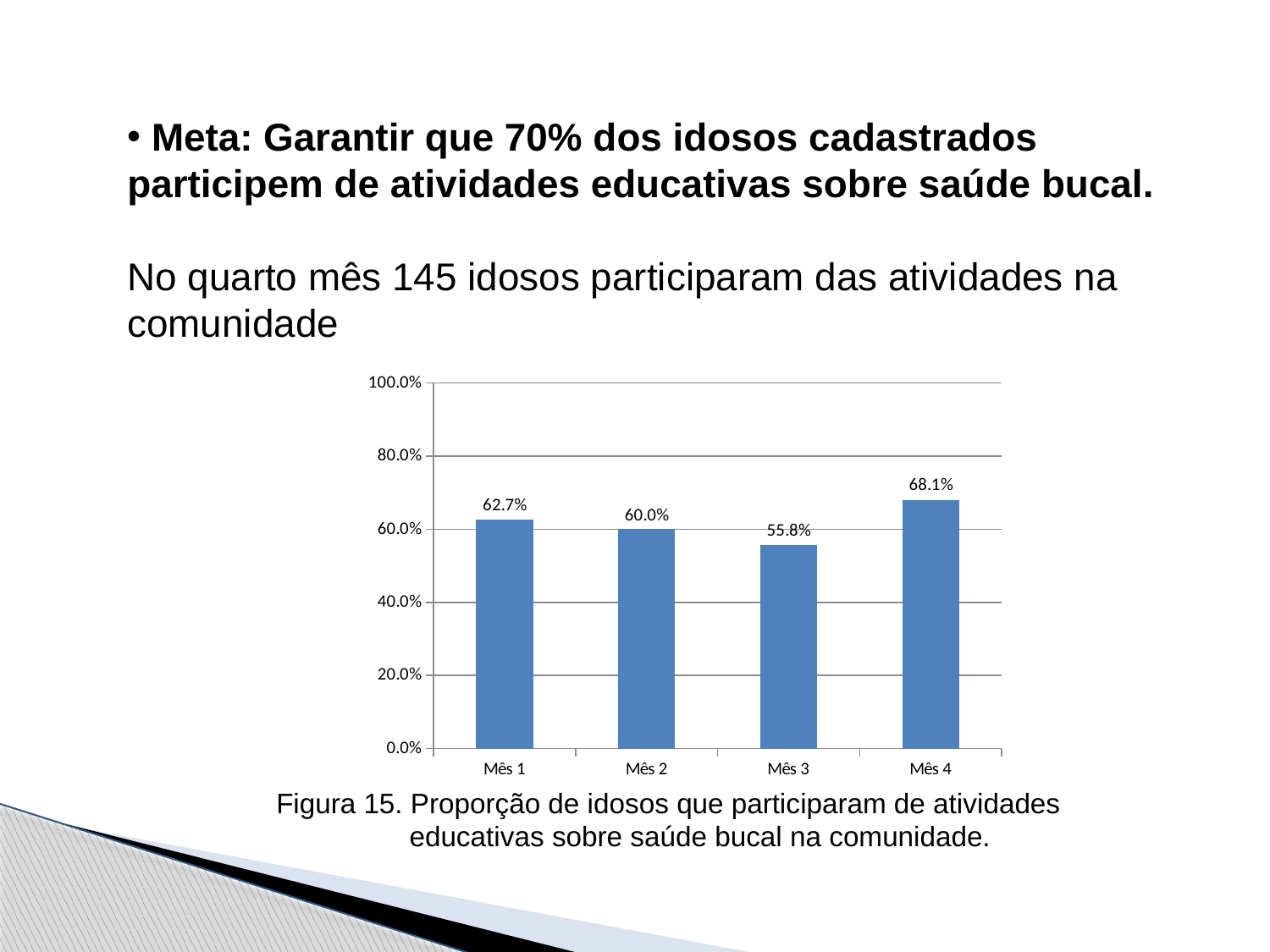
How many months are shown on the x axis? 4 What is the difference between the values for Mês 4 and Mês 3? 12.3% Which month has the highest value? Mês 4 What is the value for Mês 3? 55.8% Which is larger, the value for Mês 1 or Mês 2? Mês 1 Is the value for Mês 4 greater or less than 60.0%? greater What is the figure number given in the caption below the chart? Figura 15 Which month has the lowest value? Mês 3 What kind of chart is shown on the slide? Bar chart What is the value for Mês 1? 62.7% What is the value for Mês 4? 68.1% Does the value rise or fall from Mês 3 to Mês 4? Rise